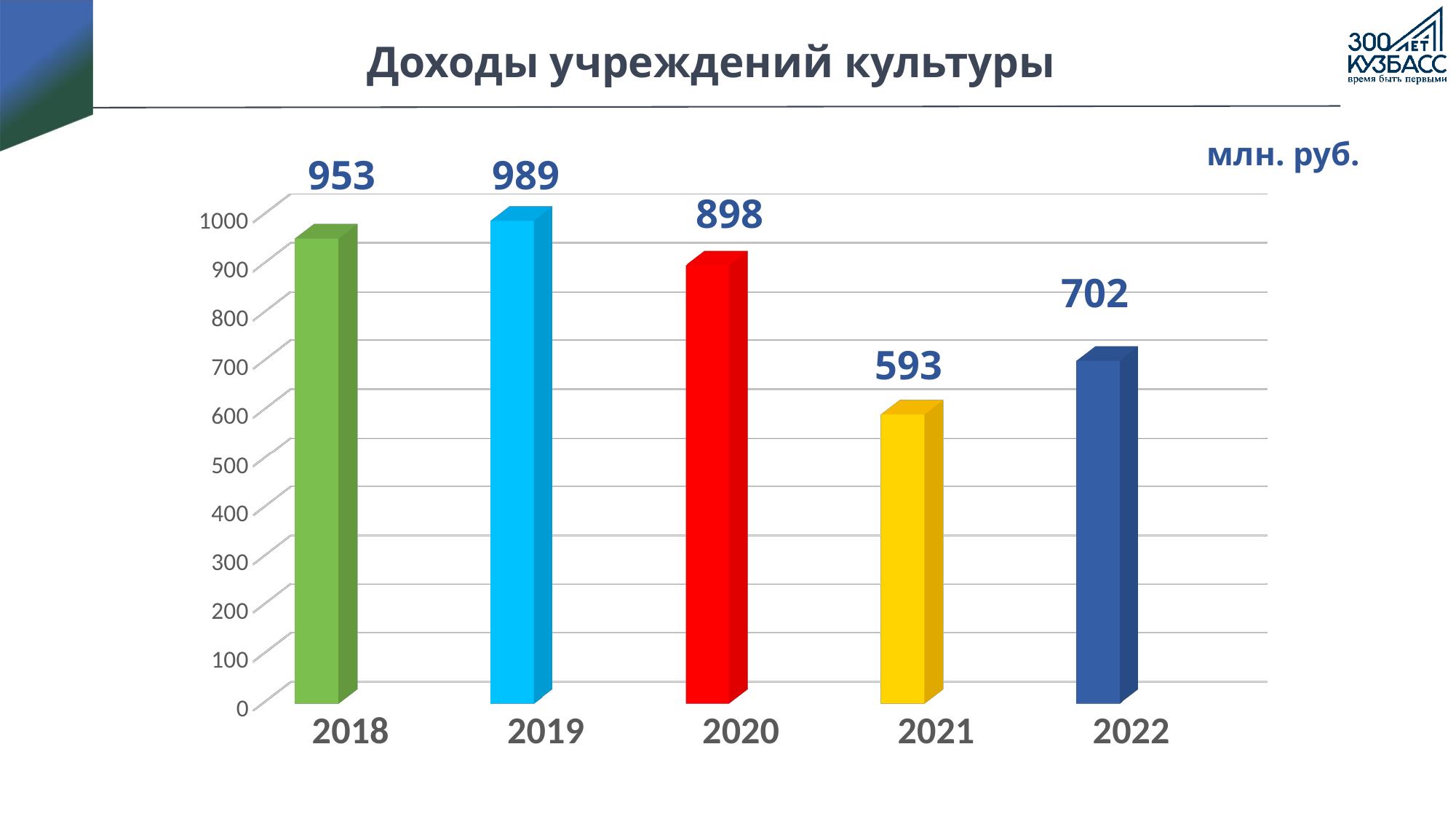
Is the value for 2021 greater or less than 600? less What is the value for 2021? 593 What is the title of the chart? Доходы учреждений культуры Which year has the lowest value? 2021 What is the value for 2018? 953 What kind of chart is shown on the slide? bar chart What is the value for 2022? 702 What is the difference between the values for 2019 and 2020? 91 Which year has the highest value? 2019 How many years are shown on the chart? 5 What is the difference between the values for 2022 and 2021? 109 Which is larger, the value for 2018 or the value for 2020? 2018